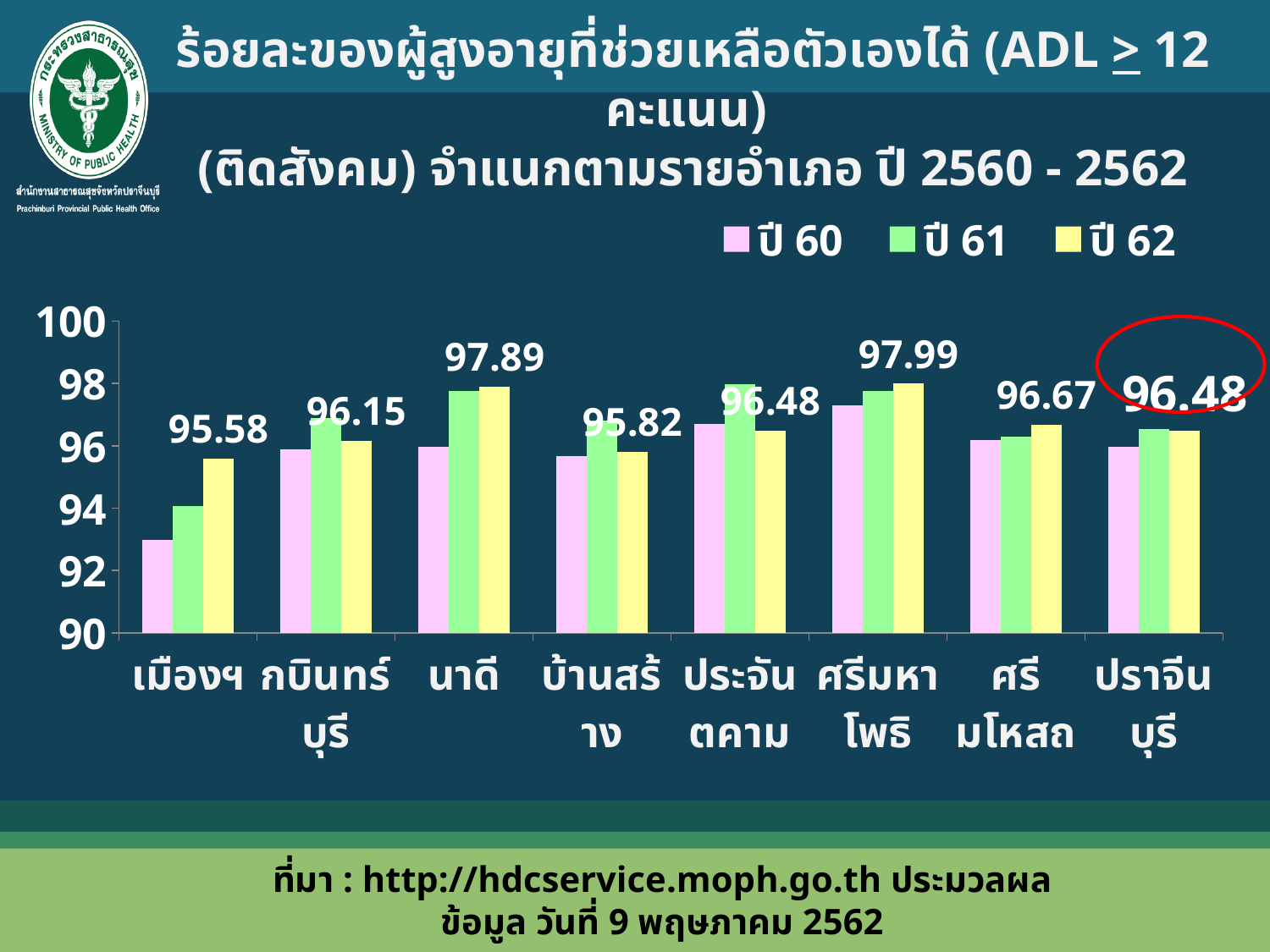
What is the ปี 62 value for ศรีมโหสถ? 96.67 What is the difference between the ปี 62 values for ศรีมหาโพธิ and เมืองฯ? 2.41 Is the ปี 60 value for เมืองฯ greater or less than 94? less How many series does the legend list? 3 Which district has the highest ปี 62 value? ศรีมหาโพธิ Which district has the lowest ปี 62 value? เมืองฯ What is the ปี 62 value for เมืองฯ? 95.58 How many districts are shown on the x axis? 8 What is the ปี 62 value for นาดี? 97.89 What kind of chart is shown on the slide? bar chart Which has the larger ปี 62 value, นาดี or กบินทร์บุรี? นาดี Is the ปี 61 value for นาดี greater or less than 96? greater